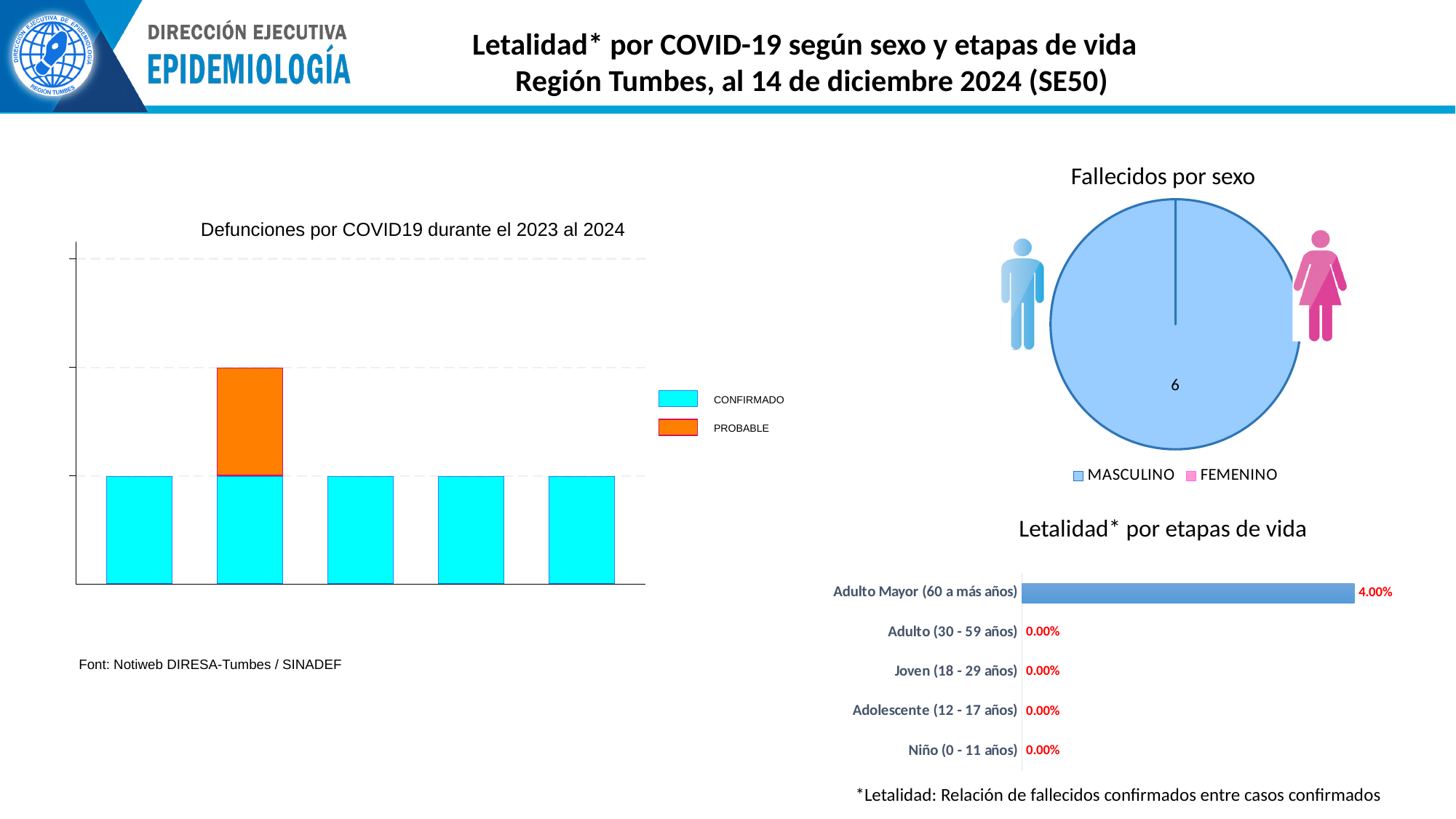
What kind of chart is 'Letalidad* por etapas de vida'? Bar chart In the chart 'Fallecidos por sexo', what value is shown for MASCULINO? 6 In the chart 'Letalidad* por etapas de vida', what is the value for Adulto Mayor (60 a más años)? 4.00% How many entries does the legend of the chart 'Fallecidos por sexo' list? 2 In the chart 'Letalidad* por etapas de vida', how many age groups are shown? 5 How many series does the legend of the chart 'Defunciones por COVID19 durante el 2023 al 2024' list? 2 In the chart 'Letalidad* por etapas de vida', what is the value for Joven (18 - 29 años)? 0.00% What kind of chart is 'Fallecidos por sexo'? Pie chart In the chart 'Letalidad* por etapas de vida', what is the difference between the values for Adulto Mayor (60 a más años) and Adulto (30 - 59 años)? 4.00% How many bars are plotted in the chart 'Defunciones por COVID19 durante el 2023 al 2024'? 5 In the chart 'Defunciones por COVID19 durante el 2023 al 2024', which colour represents PROBABLE? Orange In the chart 'Letalidad* por etapas de vida', which age group has the highest value? Adulto Mayor (60 a más años)